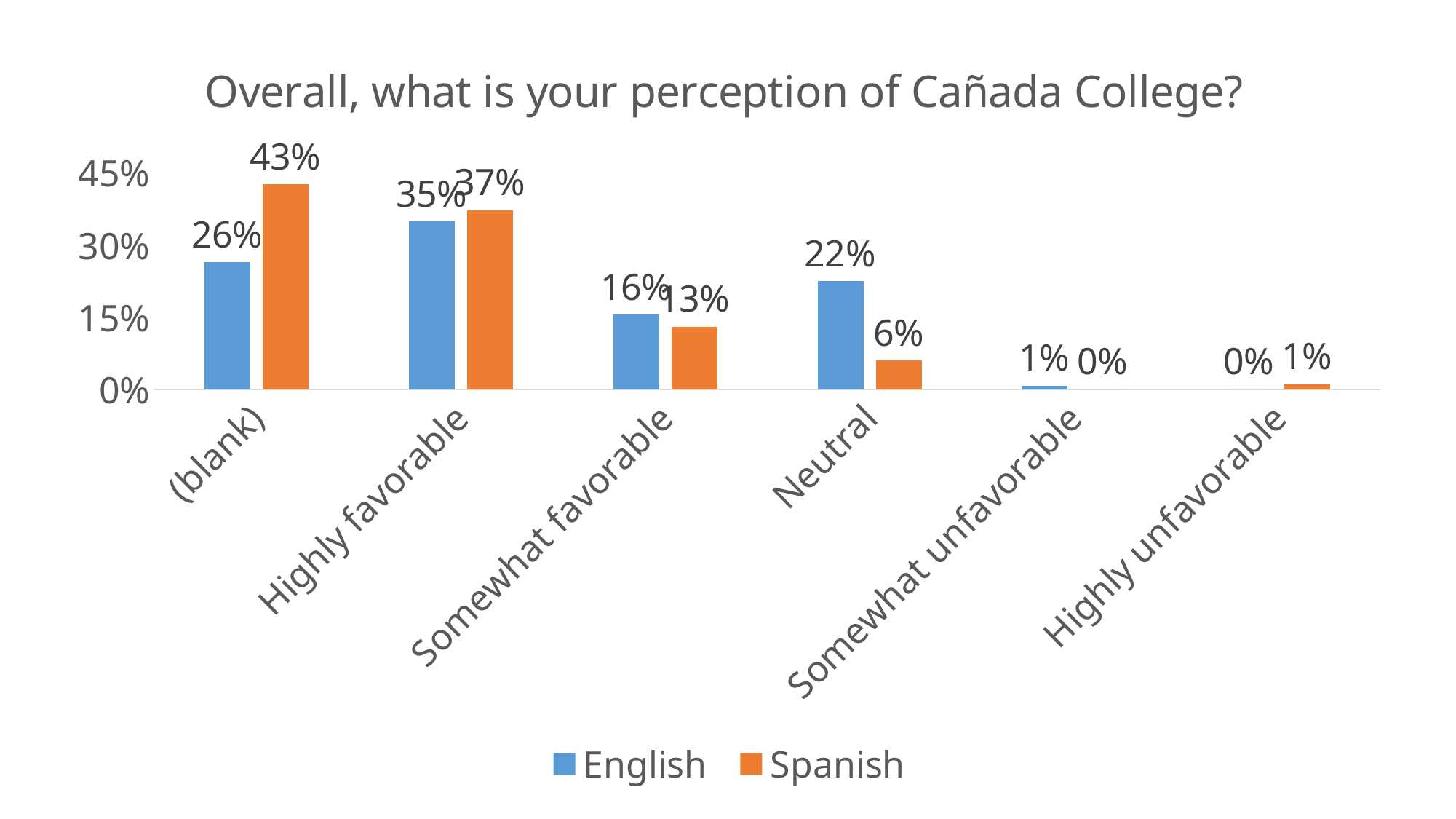
How many categories are shown on the x axis? 6 Which is larger for Somewhat favorable, the English value or the Spanish value? English What is the Spanish value for Somewhat favorable? 13% What is the difference between the English and Spanish values for Neutral? 16% What kind of chart is shown? Bar chart What is the English value for Neutral? 22% What is the title of the chart? Overall, what is your perception of Cañada College? Which category has the highest Spanish value? (blank) How many series does the legend list? 2 Which category has the highest English value? Highly favorable What is the Spanish value for (blank)? 43% What is the English value for Highly favorable? 35%